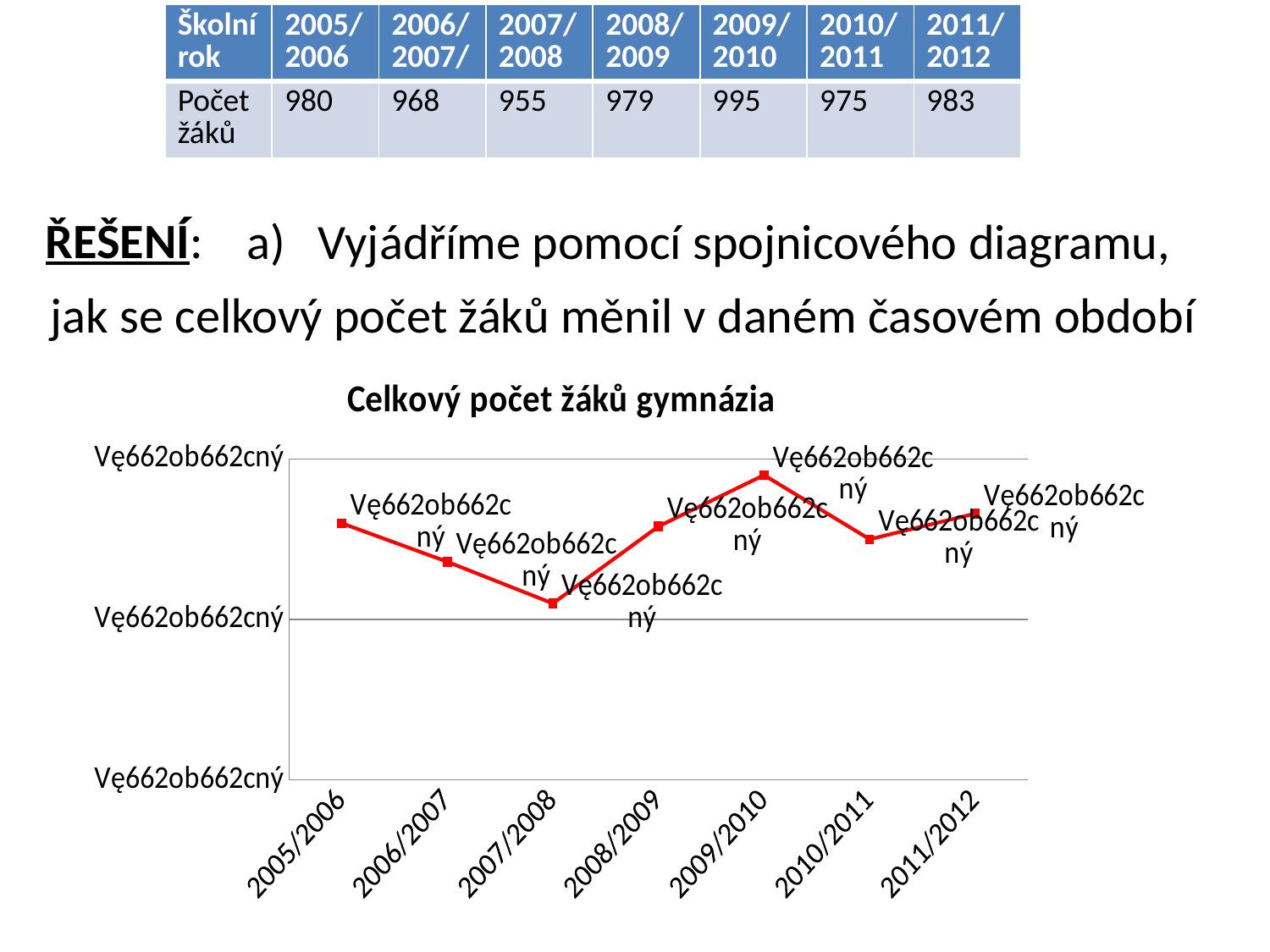
What kind of chart is shown on the slide? line chart Which school year has the highest point on the line chart? 2009/2010 Does the line rise or fall from 2007/2008 to 2009/2010? rise Which school year has the lowest point on the line chart? 2007/2008 What is the title of the chart? Celkový počet žáků gymnázia According to the table on the slide, what is the number of pupils (Počet žáků) in 2009/2010? 995 Which is higher on the line chart, 2009/2010 or 2010/2011? 2009/2010 Which is higher on the line chart, 2005/2006 or 2006/2007? 2005/2006 Does the line rise or fall from 2005/2006 to 2007/2008? fall According to the table on the slide, what is the difference between the number of pupils in 2009/2010 and in 2007/2008? 40 How many school years are plotted on the x axis of the chart? 7 Which is higher on the line chart, 2010/2011 or 2011/2012? 2011/2012